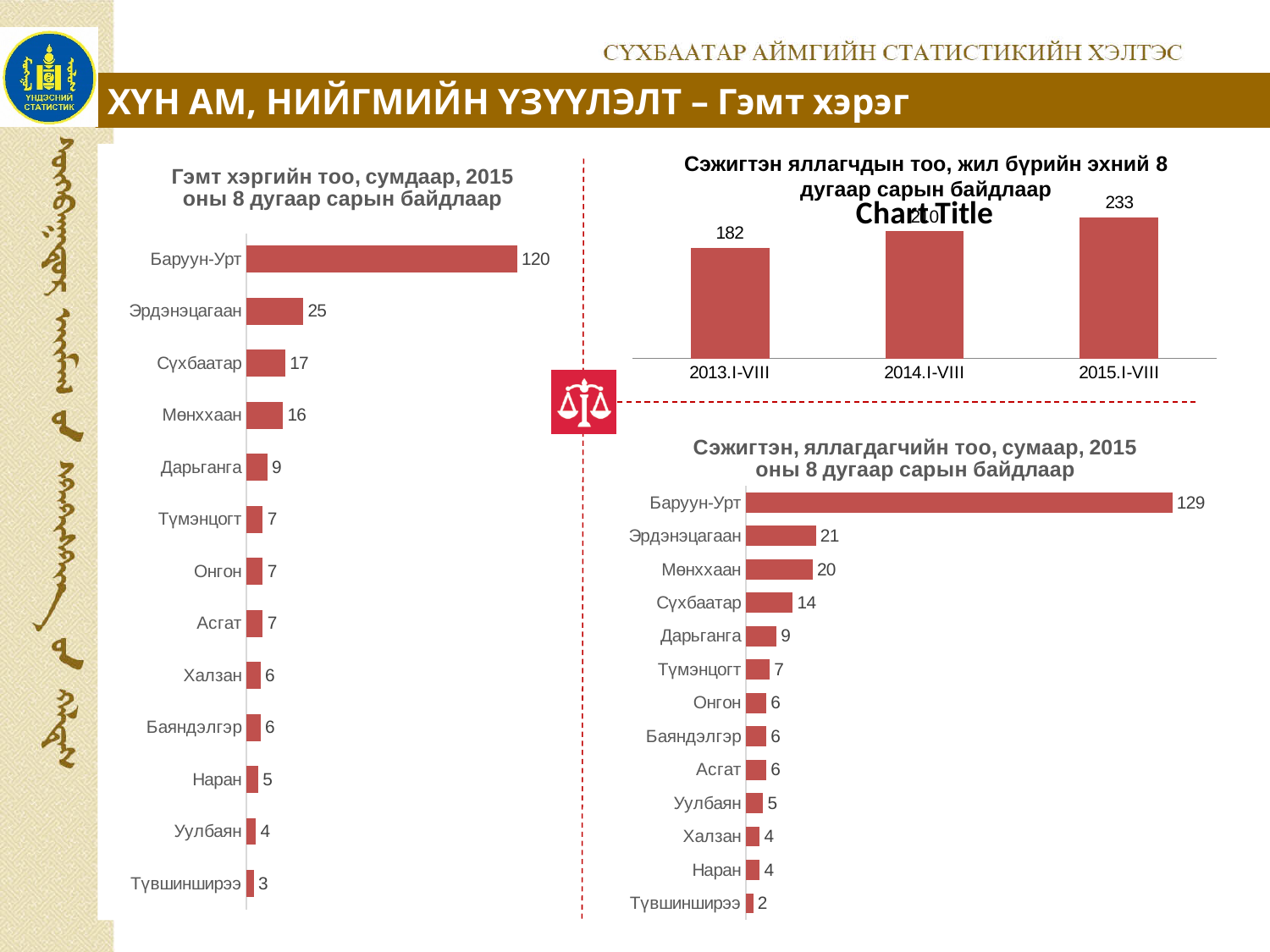
In the top-right chart 'Сэжигтэн яллагчдын тоо, жил бүрийн эхний 8 дугаар сарын байдлаар', do the values rise or fall from 2013.I-VIII to 2015.I-VIII? rise In the top-right chart 'Сэжигтэн яллагчдын тоо, жил бүрийн эхний 8 дугаар сарын байдлаар', what is the value for 2015.I-VIII? 233 What type of chart is the top-right chart 'Сэжигтэн яллагчдын тоо, жил бүрийн эхний 8 дугаар сарын байдлаар'? bar chart In the chart 'Сэжигтэн, яллагдагчийн тоо, сумаар, 2015 оны 8 дугаар сарын байдлаар', what is the value for Түвшинширээ? 2 In the top-right chart 'Сэжигтэн яллагчдын тоо, жил бүрийн эхний 8 дугаар сарын байдлаар', what is the value for 2013.I-VIII? 182 In the chart 'Гэмт хэргийн тоо, сумдаар, 2015 оны 8 дугаар сарын байдлаар', what is the value for Эрдэнэцагаан? 25 In the chart 'Сэжигтэн, яллагдагчийн тоо, сумаар, 2015 оны 8 дугаар сарын байдлаар', which is larger, Эрдэнэцагаан or Сүхбаатар? Эрдэнэцагаан In the chart 'Гэмт хэргийн тоо, сумдаар, 2015 оны 8 дугаар сарын байдлаар', what is the value for Баруун-Урт? 120 In the chart 'Гэмт хэргийн тоо, сумдаар, 2015 оны 8 дугаар сарын байдлаар', which category has the lowest value? Түвшинширээ In the chart 'Сэжигтэн, яллагдагчийн тоо, сумаар, 2015 оны 8 дугаар сарын байдлаар', what is the value for Баруун-Урт? 129 In the chart 'Гэмт хэргийн тоо, сумдаар, 2015 оны 8 дугаар сарын байдлаар', what is the difference between Сүхбаатар and Мөнххаан? 1 How many categories are shown in the chart 'Гэмт хэргийн тоо, сумдаар, 2015 оны 8 дугаар сарын байдлаар'? 13